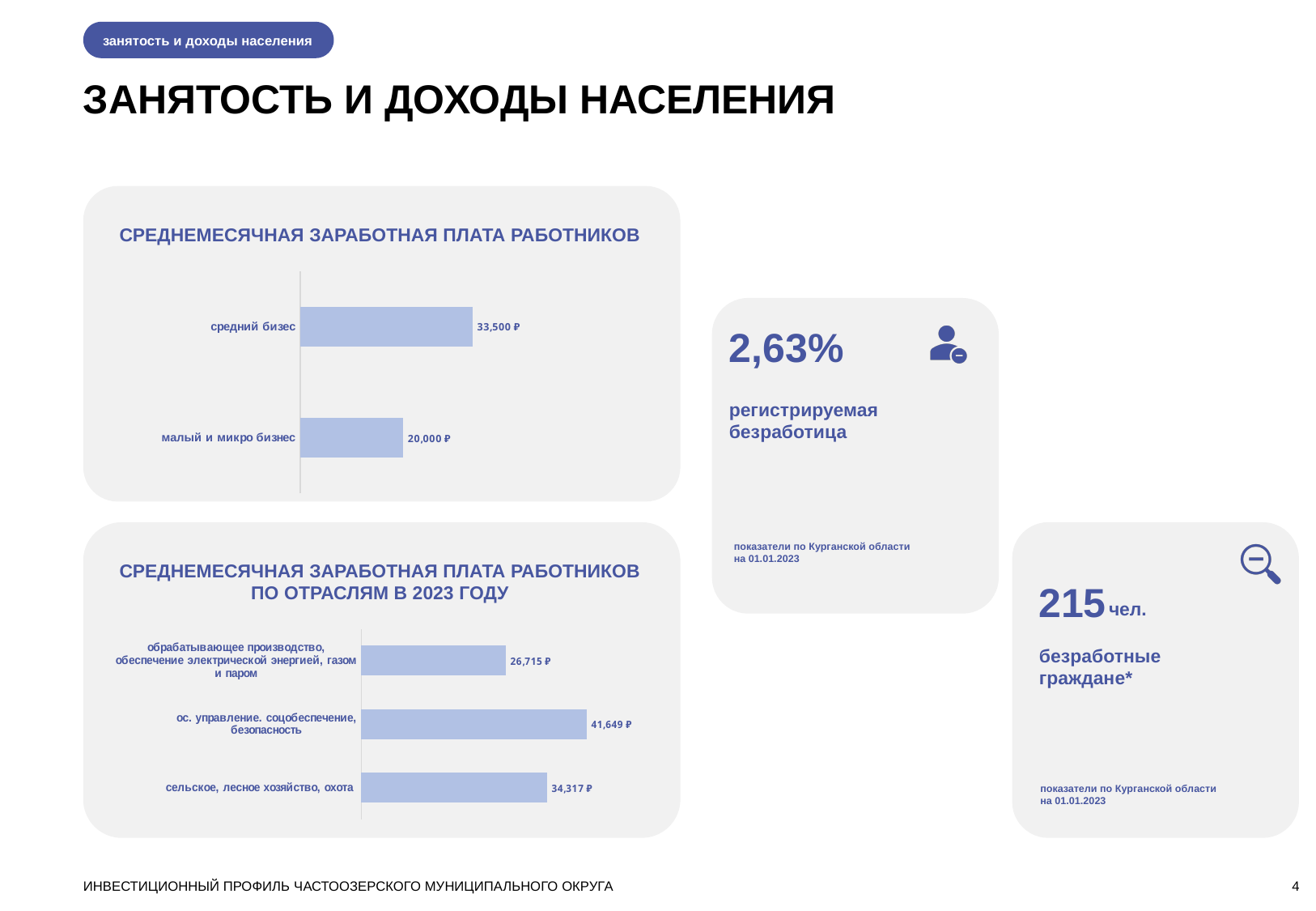
In the bottom chart 'СРЕДНЕМЕСЯЧНАЯ ЗАРАБОТНАЯ ПЛАТА РАБОТНИКОВ ПО ОТРАСЛЯМ В 2023 ГОДУ', which category has the lowest value? обрабатывающее производство, обеспечение электрической энергией, газом и паром In the bottom chart 'СРЕДНЕМЕСЯЧНАЯ ЗАРАБОТНАЯ ПЛАТА РАБОТНИКОВ ПО ОТРАСЛЯМ В 2023 ГОДУ', what is the difference between the values for 'гос. управление, соцобеспечение, безопасность' and 'сельское, лесное хозяйство, охота'? 7,332 ₽ How many categories are shown in the top chart 'СРЕДНЕМЕСЯЧНАЯ ЗАРАБОТНАЯ ПЛАТА РАБОТНИКОВ'? 2 How many categories are shown in the bottom chart 'СРЕДНЕМЕСЯЧНАЯ ЗАРАБОТНАЯ ПЛАТА РАБОТНИКОВ ПО ОТРАСЛЯМ В 2023 ГОДУ'? 3 In the bottom chart 'СРЕДНЕМЕСЯЧНАЯ ЗАРАБОТНАЯ ПЛАТА РАБОТНИКОВ ПО ОТРАСЛЯМ В 2023 ГОДУ', which category has the highest value? гос. управление, соцобеспечение, безопасность In the bottom chart 'СРЕДНЕМЕСЯЧНАЯ ЗАРАБОТНАЯ ПЛАТА РАБОТНИКОВ ПО ОТРАСЛЯМ В 2023 ГОДУ', what is the value for 'сельское, лесное хозяйство, охота'? 34,317 ₽ In the top chart 'СРЕДНЕМЕСЯЧНАЯ ЗАРАБОТНАЯ ПЛАТА РАБОТНИКОВ', what is the value for 'средний бизнес'? 33,500 ₽ What kind of chart is the bottom chart 'СРЕДНЕМЕСЯЧНАЯ ЗАРАБОТНАЯ ПЛАТА РАБОТНИКОВ ПО ОТРАСЛЯМ В 2023 ГОДУ'? Bar chart In the top chart 'СРЕДНЕМЕСЯЧНАЯ ЗАРАБОТНАЯ ПЛАТА РАБОТНИКОВ', what is the difference between the values for 'средний бизнес' and 'малый и микро бизнес'? 13,500 ₽ In the bottom chart 'СРЕДНЕМЕСЯЧНАЯ ЗАРАБОТНАЯ ПЛАТА РАБОТНИКОВ ПО ОТРАСЛЯМ В 2023 ГОДУ', what is the value for 'гос. управление, соцобеспечение, безопасность'? 41,649 ₽ In the top chart 'СРЕДНЕМЕСЯЧНАЯ ЗАРАБОТНАЯ ПЛАТА РАБОТНИКОВ', what is the value for 'малый и микро бизнес'? 20,000 ₽ In the top chart 'СРЕДНЕМЕСЯЧНАЯ ЗАРАБОТНАЯ ПЛАТА РАБОТНИКОВ', which category has the higher value? средний бизнес